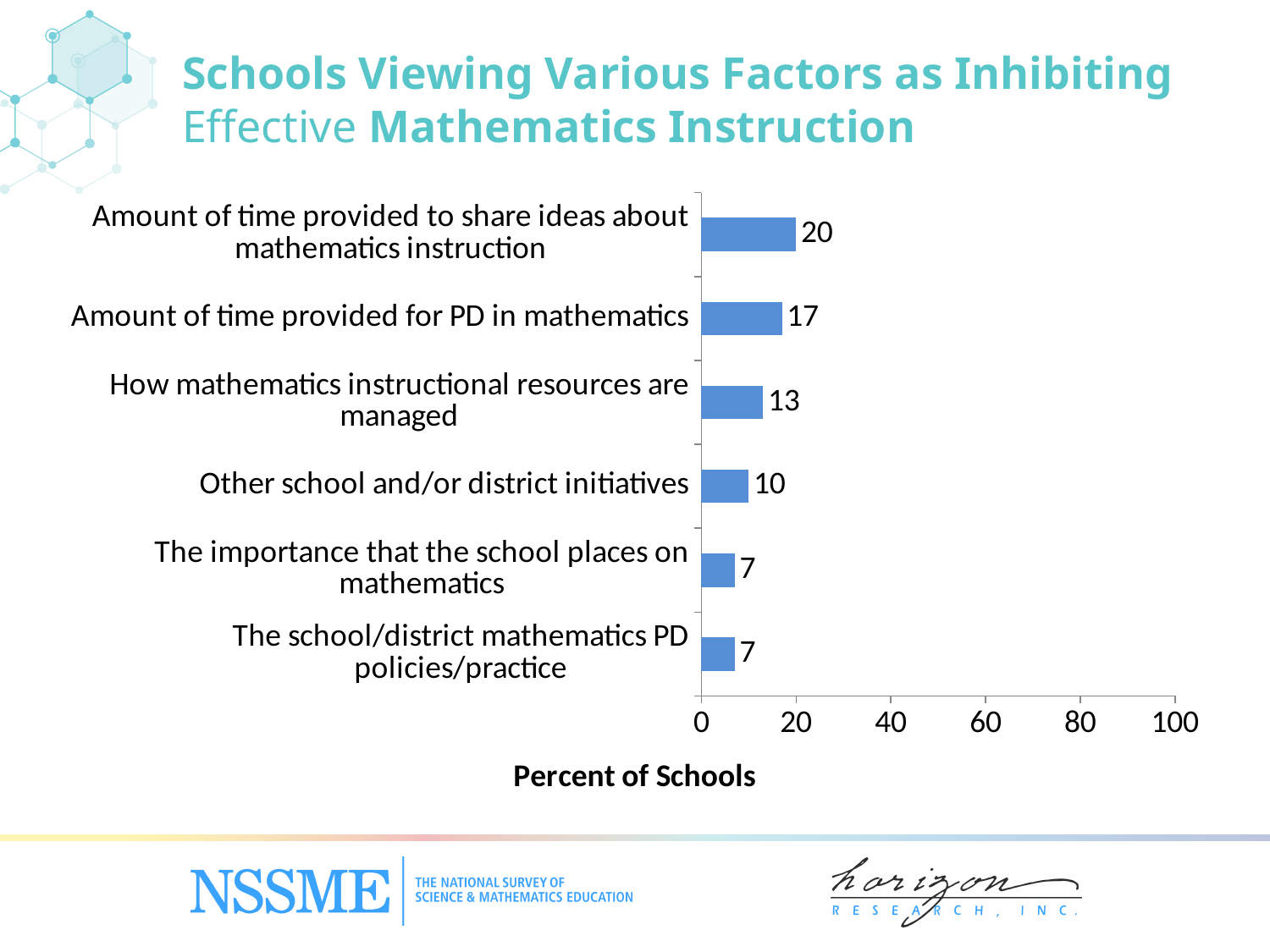
What is the value for 'Other school and/or district initiatives'? 10 Is the value for 'Amount of time provided to share ideas about mathematics instruction' greater or less than 40? less What percent of schools view the amount of time provided to share ideas about mathematics instruction as inhibiting effective mathematics instruction? 20 What is the difference between the values for 'Amount of time provided to share ideas about mathematics instruction' and 'Amount of time provided for PD in mathematics'? 3 Which factor has the highest percent of schools? Amount of time provided to share ideas about mathematics instruction What kind of chart is shown on the slide? Bar chart How many factors are shown in the chart? 6 Which is larger: the value for 'Other school and/or district initiatives' or the value for 'The importance that the school places on mathematics'? Other school and/or district initiatives What is the label of the horizontal axis? Percent of Schools What is the value for 'How mathematics instructional resources are managed'? 13 What is the difference between the values for 'How mathematics instructional resources are managed' and 'The school/district mathematics PD policies/practice'? 6 What is the value for 'Amount of time provided for PD in mathematics'? 17